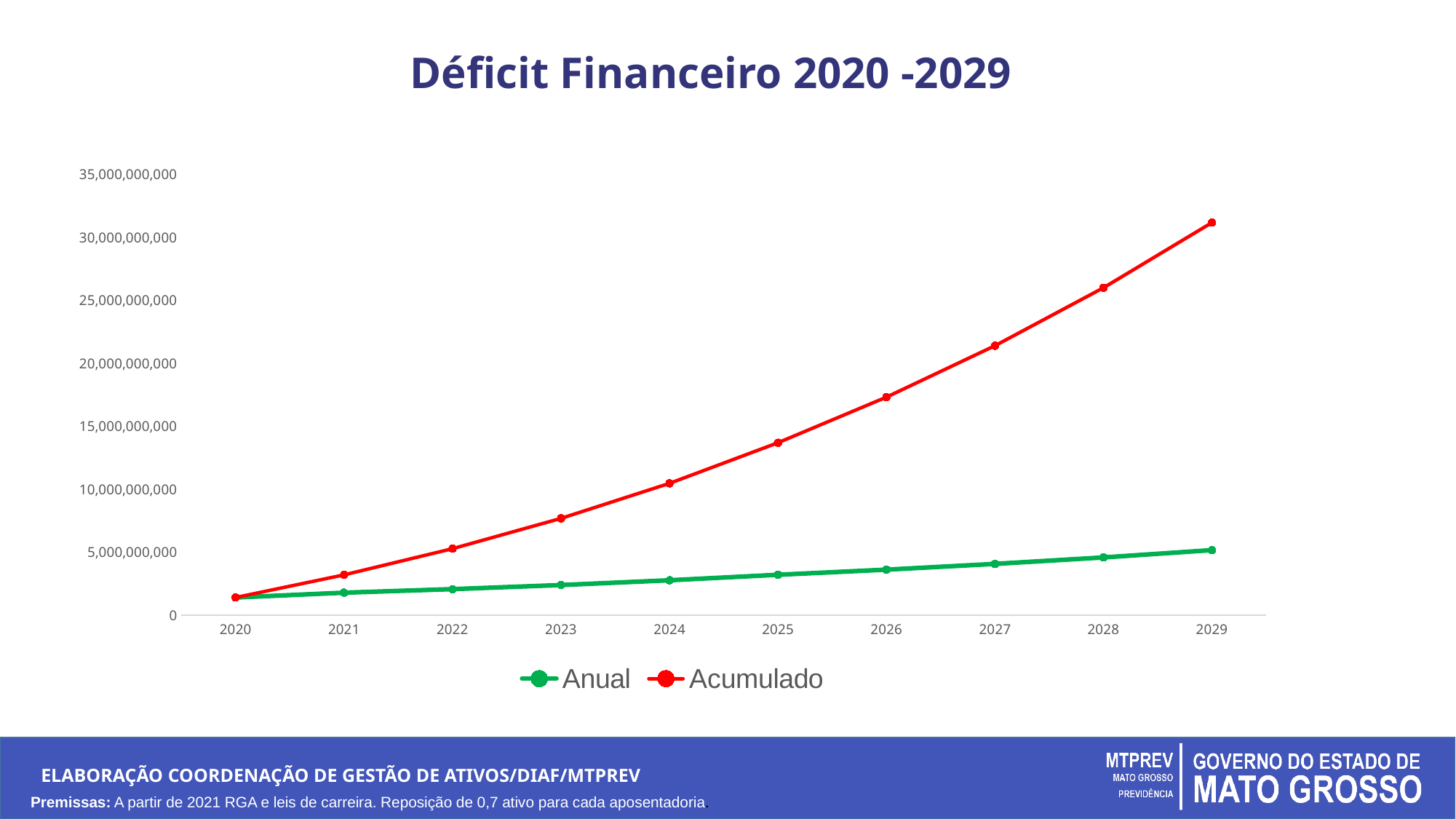
In which year is the Acumulado series at its highest? 2029 How many years are plotted along the x axis? 10 Do the Acumulado values rise or fall from 2020 to 2029? Rise How many series does the legend list? 2 Is the Acumulado value for 2025 greater or less than 15,000,000,000? less What is the title of the chart? Déficit Financeiro 2020 -2029 What kind of chart is shown on the slide? Line chart Which series is drawn in red? Acumulado Is the Anual value for 2024 greater or less than 5,000,000,000? less In 2029, which series has the larger value, Anual or Acumulado? Acumulado Is the Acumulado value for 2029 greater or less than 30,000,000,000? greater In which year is the Anual series at its lowest? 2020